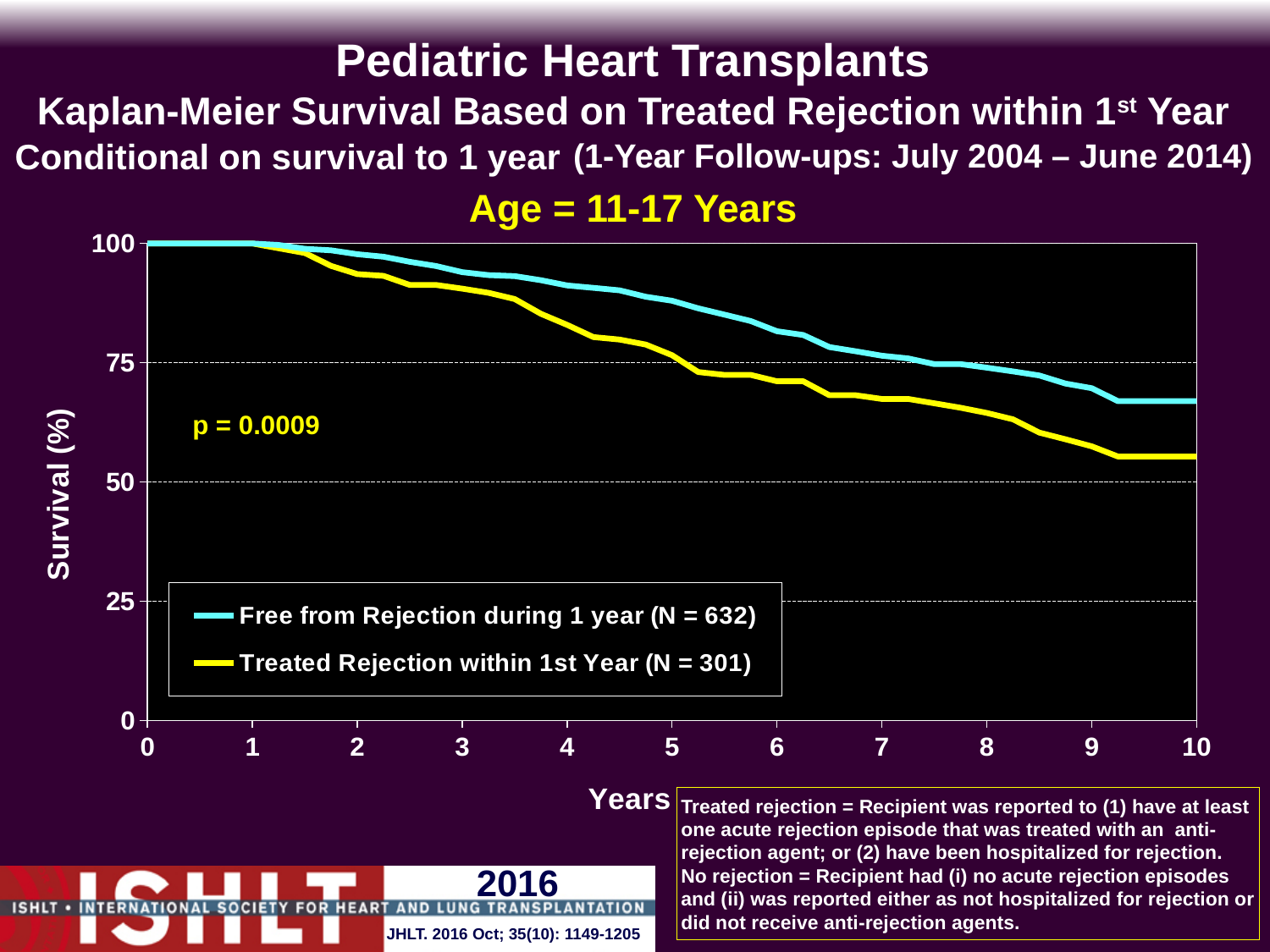
Do the survival curves rise or fall as years increase? fall What kind of chart is shown on the slide? Line chart (Kaplan-Meier survival curve) What p-value is printed on the chart? p = 0.0009 Which colour is used for the Treated Rejection within 1st Year curve? Yellow What is the N for the 'Free from Rejection during 1 year' group? 632 Which group has the higher survival at 10 years, Free from Rejection or Treated Rejection? Free from Rejection during 1 year Is the survival for the Free from Rejection during 1 year group at 10 years greater or less than 50? greater What is the N for the 'Treated Rejection within 1st Year' group? 301 How many series does the legend list? 2 Is the survival for the Treated Rejection within 1st Year group at 8 years greater or less than 75? less Is the survival for the Treated Rejection within 1st Year group at 10 years greater or less than 75? less